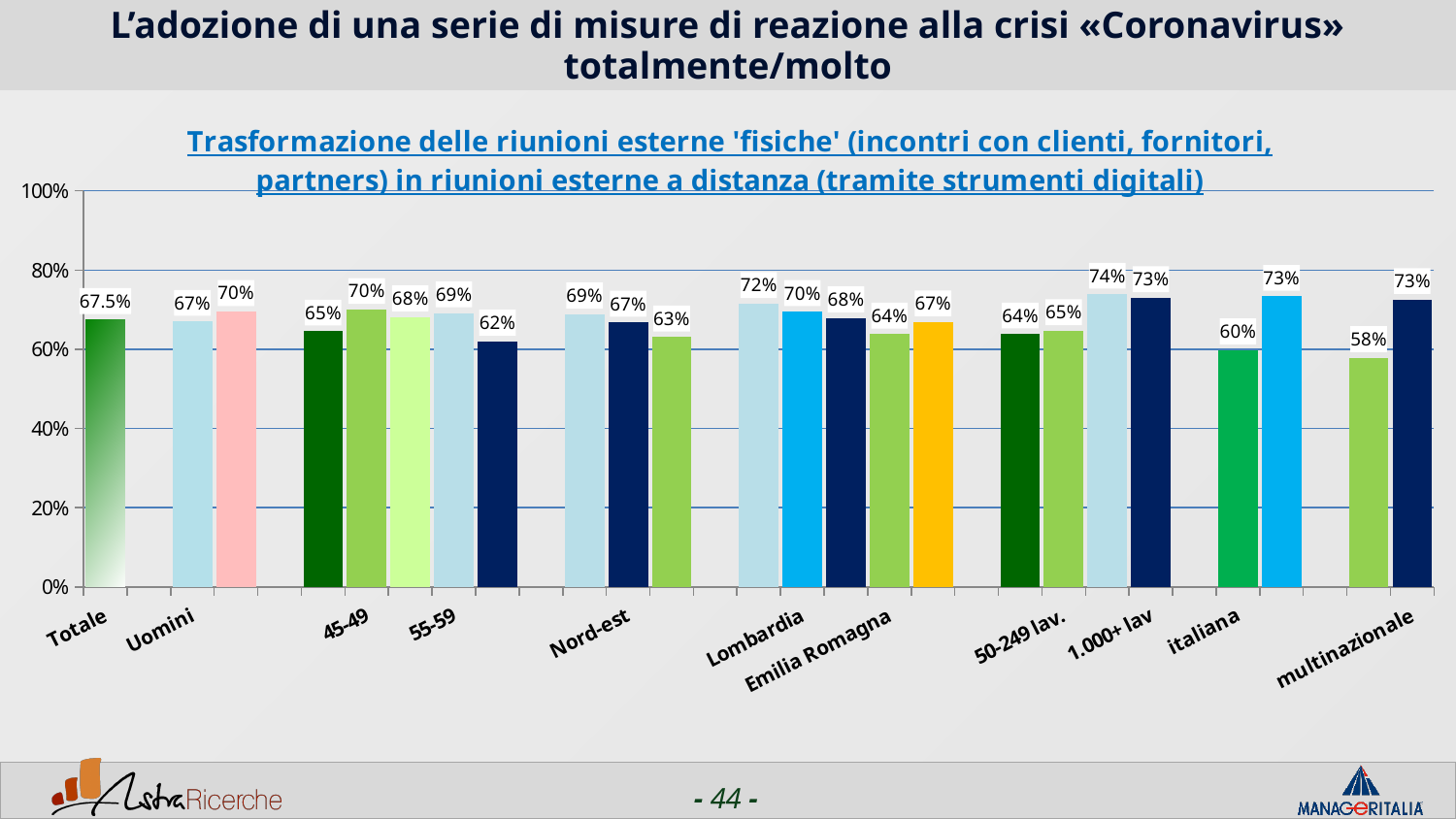
What is the value for Uomini? 67% What is the value for multinazionale? 73% What is the difference between the value for multinazionale and the value for italiana? 13% What is the value for Lombardia? 70% What is the value for the 45-49 age group? 70% What is the highest value shown on the y axis? 100% What is the value for Emilia Romagna? 64% What is the value for italiana? 60% Which is larger, the value for 1.000+ lav or the value for 50-249 lav.? 1.000+ lav What is the value for Totale? 67.5% Is the value for 55-59 greater or less than 60%? greater What kind of chart is shown on the slide? bar chart